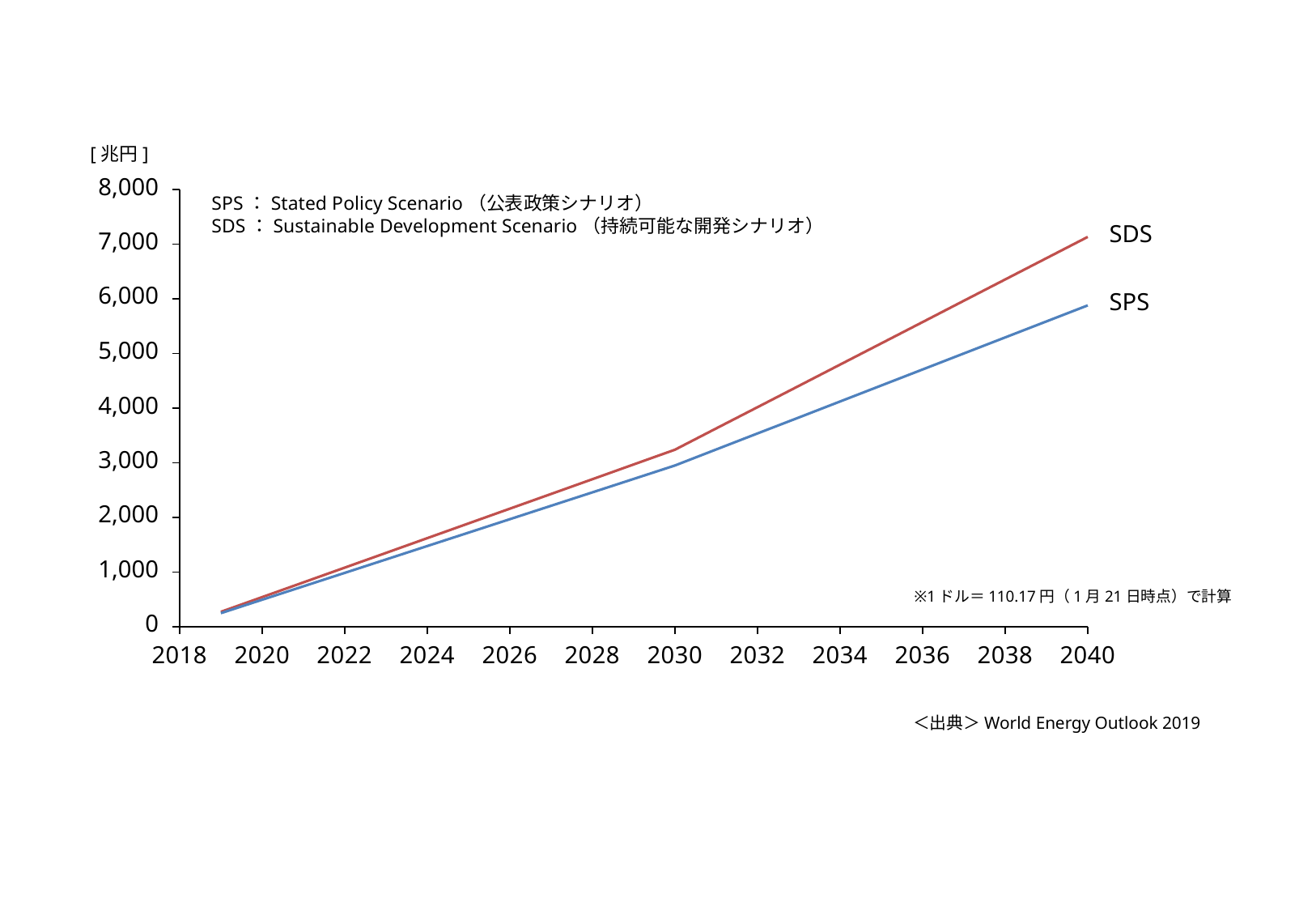
What are the names of the two series plotted on the chart? SDS and SPS Do the values of the SDS line rise or fall from 2019 to 2040? rise How many series (lines) are plotted on the chart? 2 Do the values of the SPS line rise or fall from 2019 to 2040? rise What kind of chart is shown on the slide? line chart Is the value for SDS in 2030 greater or less than 3,000? greater Is the value for SPS in 2024 greater or less than 2,000? less Is the value for SDS in 2040 greater or less than 7,000? greater Which series has the higher value in 2040, SDS or SPS? SDS What unit is shown on the y axis of the chart? 兆円